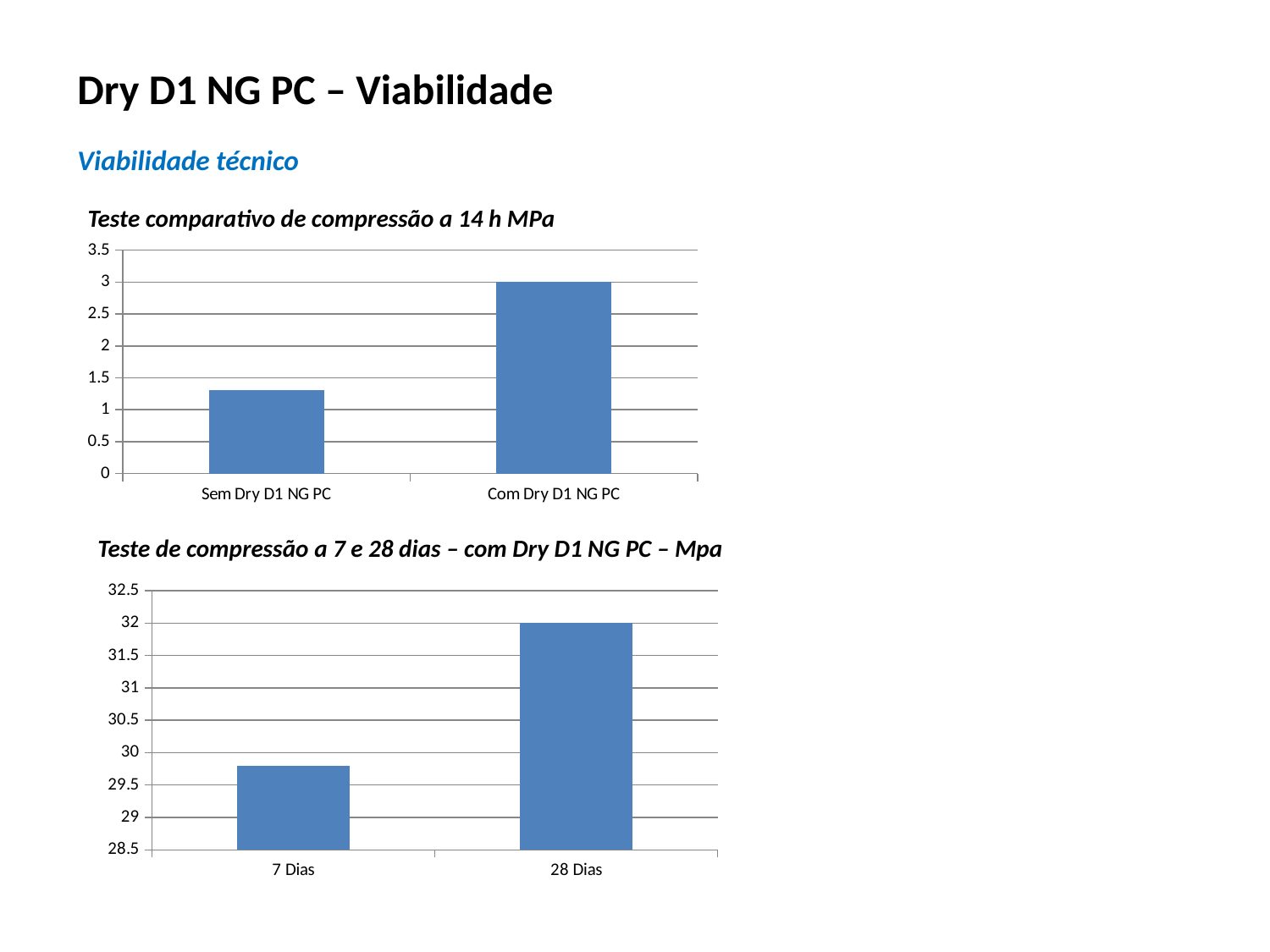
What is the title of the bottom chart on the slide? Teste de compressão a 7 e 28 dias – com Dry D1 NG PC – Mpa What kind of chart is the top chart (Teste comparativo de compressão a 14 h MPa)? bar chart In the top chart (Teste comparativo de compressão a 14 h MPa), is the value for Sem Dry D1 NG PC greater or less than 1.5? less In the bottom chart (Teste de compressão a 7 e 28 dias), which category has the lowest value? 7 Dias In the top chart (Teste comparativo de compressão a 14 h MPa), which category has the highest value? Com Dry D1 NG PC In the bottom chart (Teste de compressão a 7 e 28 dias), do the values rise or fall from 7 Dias to 28 Dias? rise In the top chart (Teste comparativo de compressão a 14 h MPa), how many categories are shown? 2 In the top chart (Teste comparativo de compressão a 14 h MPa), is the value for Sem Dry D1 NG PC greater or less than 1? greater In the bottom chart (Teste de compressão a 7 e 28 dias), is the value for 7 Dias greater or less than 30? less In the top chart (Teste comparativo de compressão a 14 h MPa), what is the value for Com Dry D1 NG PC? 3 In the bottom chart (Teste de compressão a 7 e 28 dias), which is larger, the value for 7 Dias or the value for 28 Dias? 28 Dias In the bottom chart (Teste de compressão a 7 e 28 dias), what is the value for 28 Dias? 32